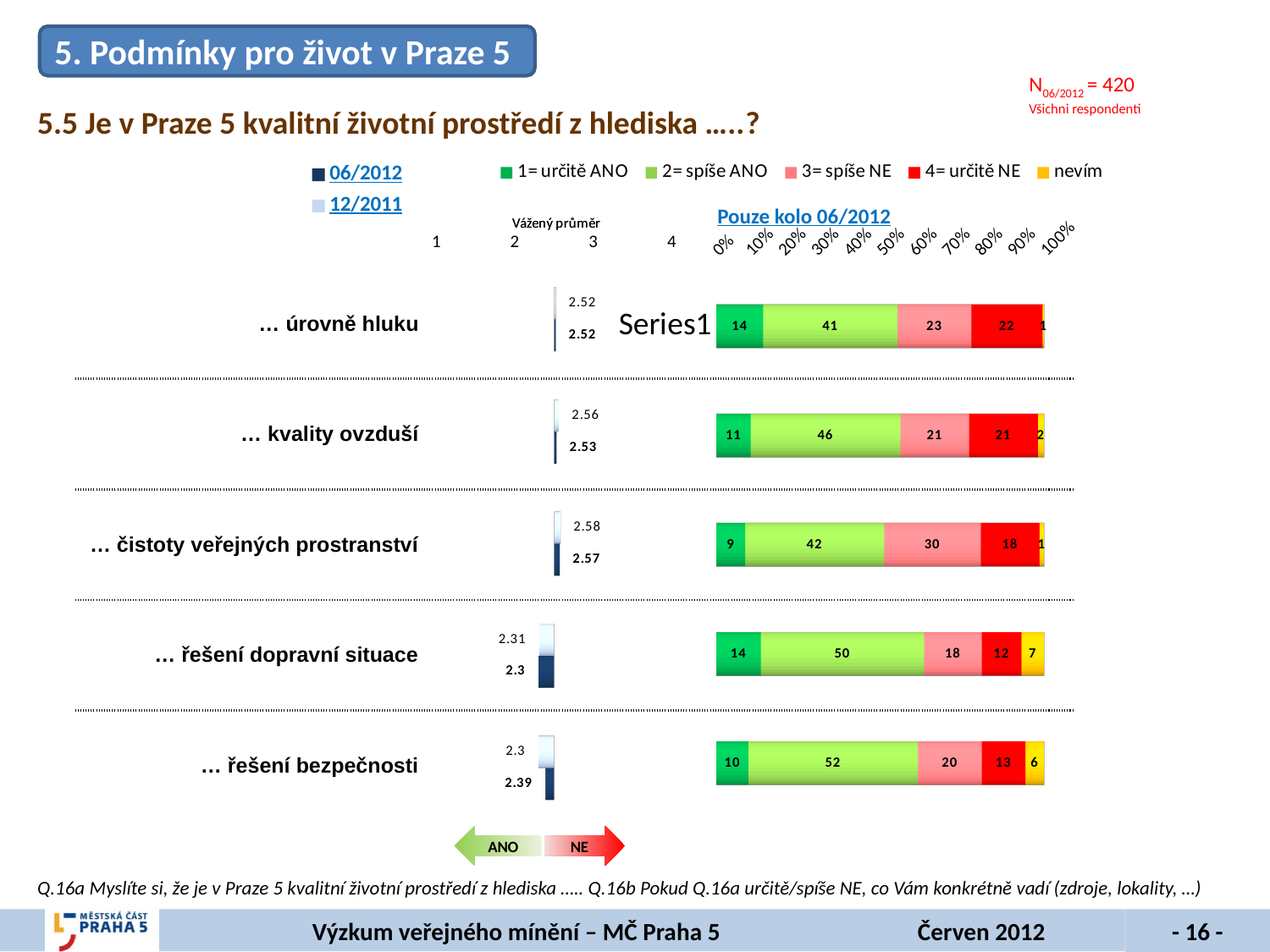
In the stacked bar chart (Pouze kolo 06/2012), is the "nevím" value larger for "… řešení dopravní situace" or for "… řešení bezpečnosti"? … řešení dopravní situace What type of chart is used in the "Pouze kolo 06/2012" section? Stacked bar chart In the stacked bar chart (Pouze kolo 06/2012), what is the value of "3= spíše NE" for "… čistoty veřejných prostranství"? 30 In the "Vážený průměr" chart, what is the bold (06/2012) weighted average for "… řešení bezpečnosti"? 2.39 In the stacked bar chart (Pouze kolo 06/2012), what is the value of "4= určitě NE" for "… úrovně hluku"? 22 In the stacked bar chart (Pouze kolo 06/2012), which item has the lowest "1= určitě ANO" value? … čistoty veřejných prostranství How many series does the legend of the stacked bar chart (Pouze kolo 06/2012) list? 5 How many items (rows) are shown in the stacked bar chart (Pouze kolo 06/2012)? 5 In the "Vážený průměr" chart, what is the non-bold (12/2011) weighted average for "… čistoty veřejných prostranství"? 2.58 In the stacked bar chart (Pouze kolo 06/2012), what is the difference between the "4= určitě NE" values for "… úrovně hluku" and "… řešení dopravní situace"? 10 In the stacked bar chart (Pouze kolo 06/2012), which item has the highest "2= spíše ANO" value? … řešení bezpečnosti In the stacked bar chart (Pouze kolo 06/2012), what percentage answered "2= spíše ANO" for "… řešení bezpečnosti"? 52